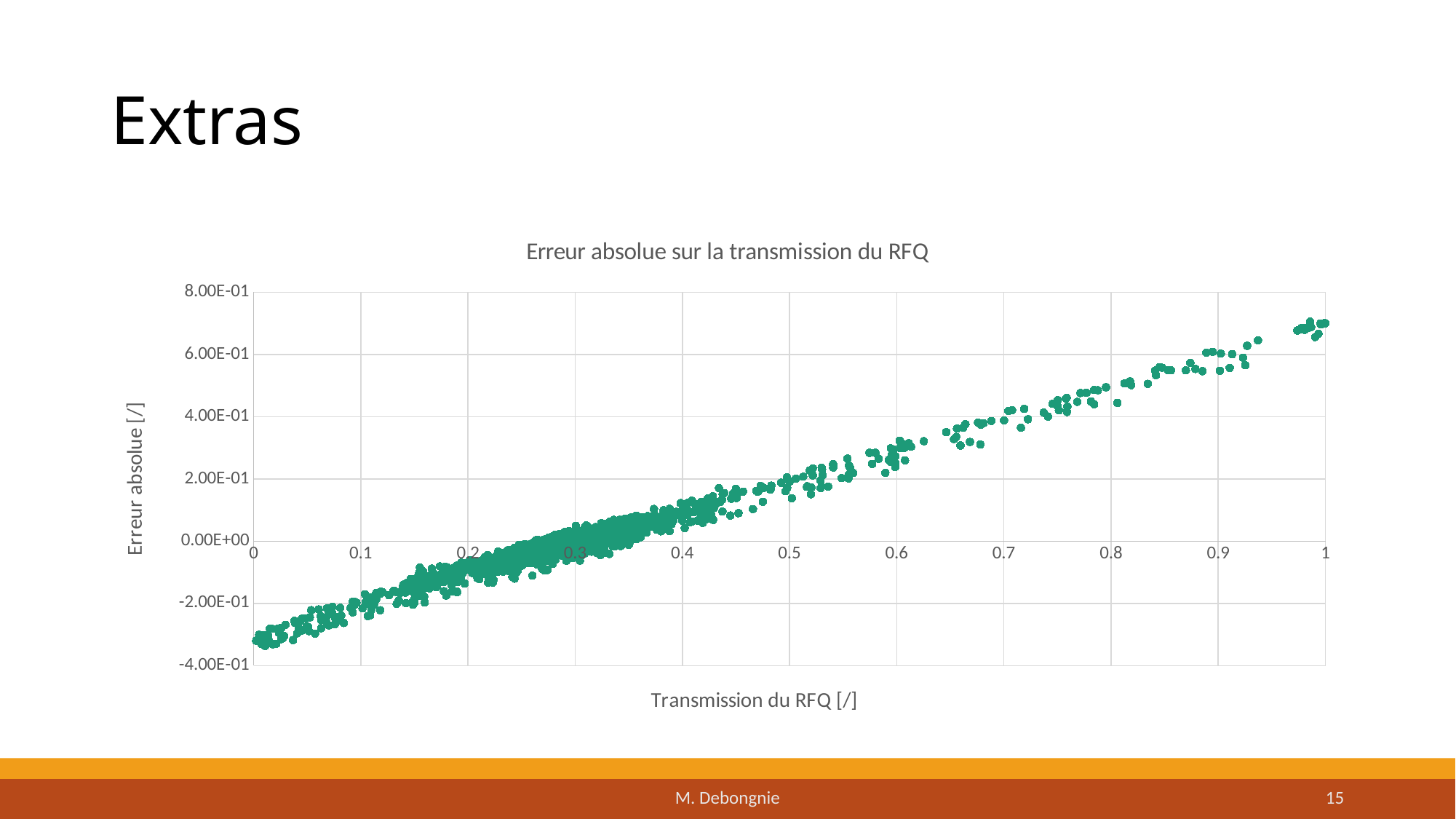
Are the values for transmission near 1 greater or less than 6.00E-01? greater Is the error at transmission near 1 larger or smaller than the error at transmission near 0? larger Are the values for transmission near 0.2 greater or less than 0.00E+00? less What is the title of the chart? Erreur absolue sur la transmission du RFQ What kind of chart is shown on the slide? scatter plot What is the highest value shown on the y axis? 8.00E-01 What is the label of the x axis? Transmission du RFQ [/] Do the plotted values rise or fall as the transmission increases along the x axis? rise Are the values for transmission near 0.8 greater or less than 4.00E-01? greater